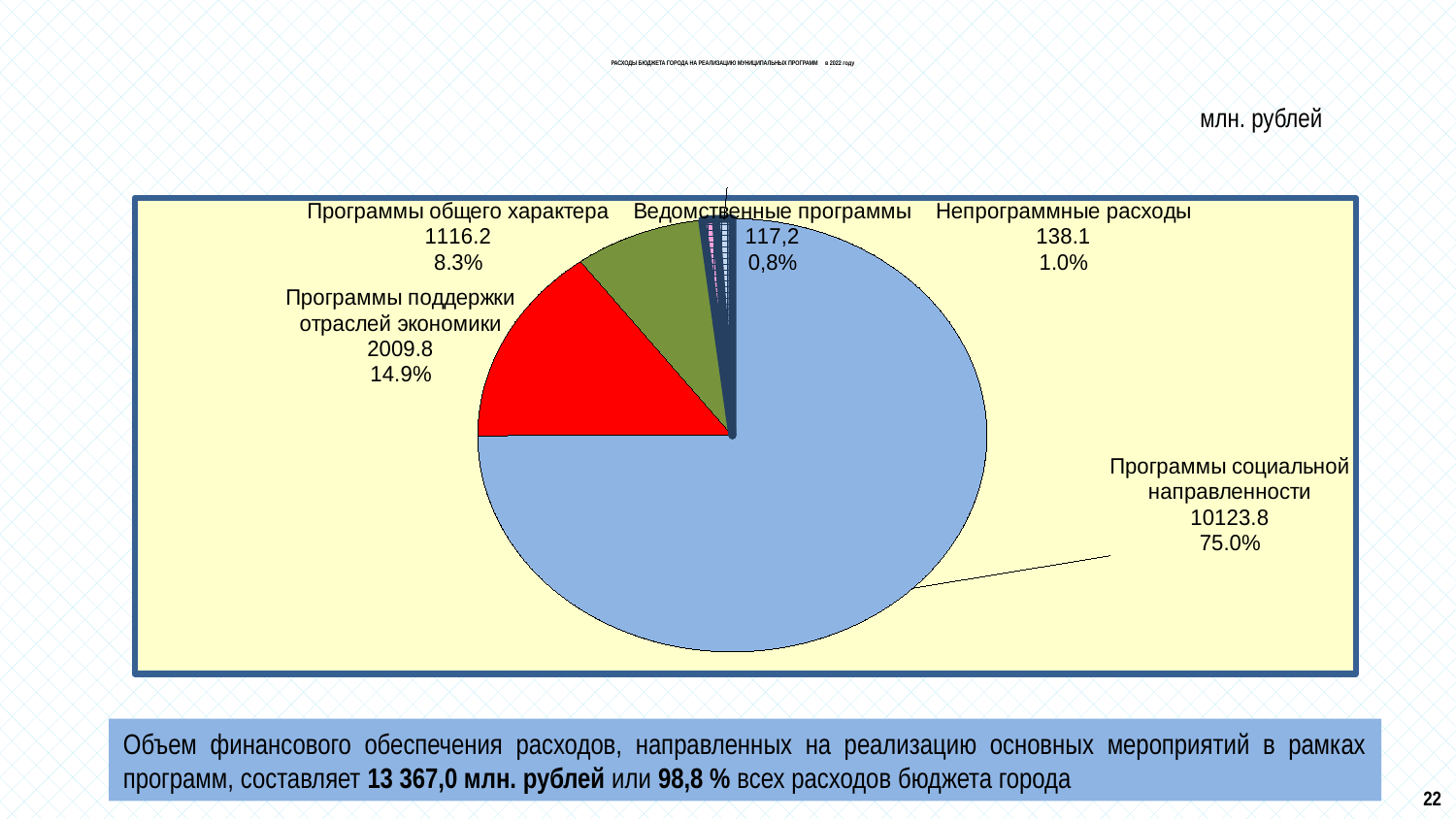
How many slices does the pie chart have? 5 Which is larger, Программы поддержки отраслей экономики or Программы общего характера? Программы поддержки отраслей экономики Which category has the largest slice of the pie? Программы социальной направленности What percentage is shown for Программы общего характера? 8.3% What is the value for Непрограммные расходы? 138.1 What kind of chart is shown on the slide? pie chart What is the difference between the values for Программы поддержки отраслей экономики and Программы общего характера? 893.6 What share of the pie does Программы социальной направленности take? 75.0% What is the value for Программы социальной направленности? 10123.8 What is the value for Ведомственные программы? 117,2 Which category has the smallest slice of the pie? Ведомственные программы What is the value for Программы поддержки отраслей экономики? 2009.8